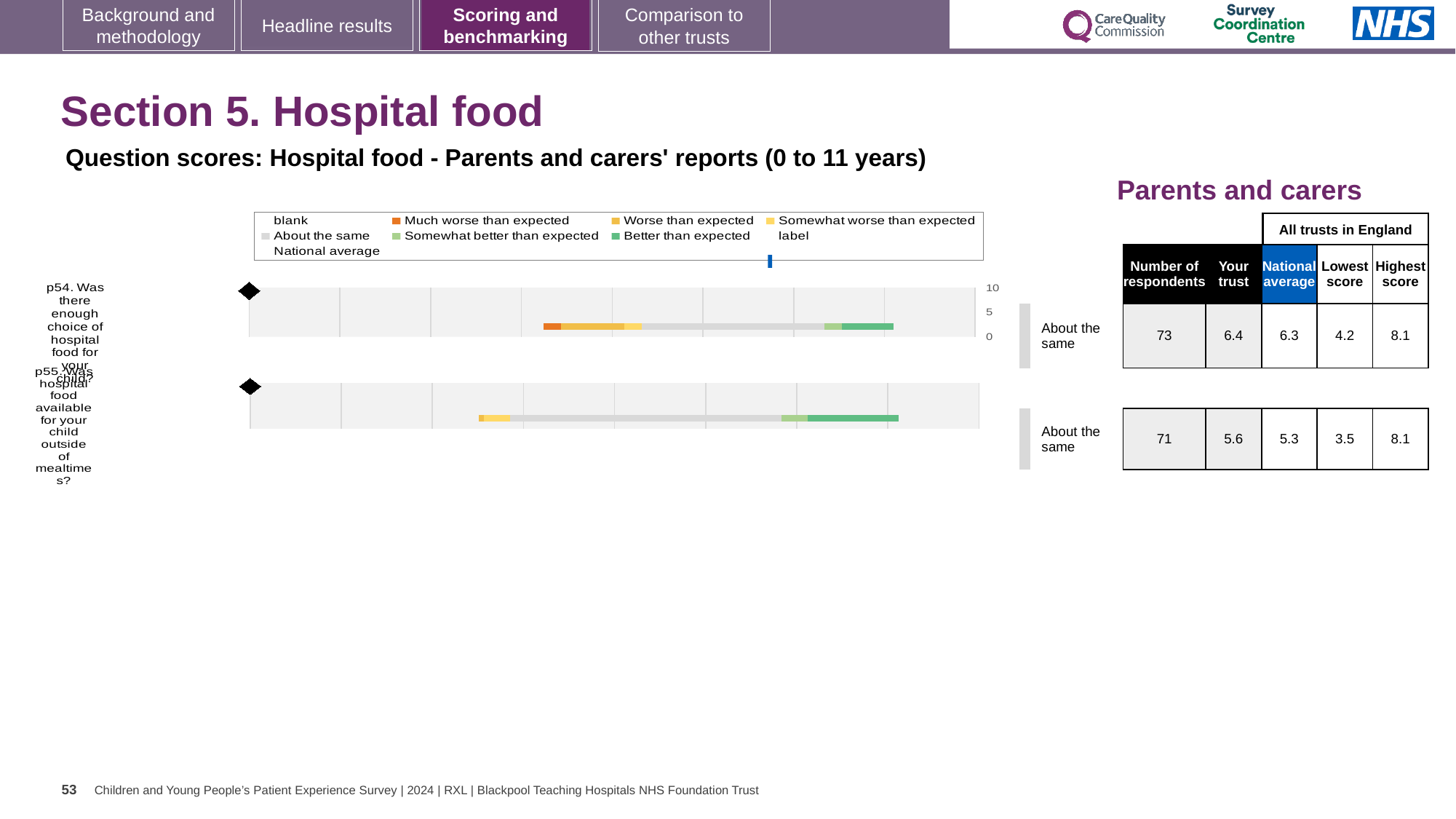
How many questions are plotted in the hospital food chart? 2 What is the difference between the highest and lowest scores for p55? 4.6 What kind of chart is used to show the question scores for p54 and p55? bar chart Which question has the higher 'Your trust' score, p54 or p55? p54 What is the national average score for p55 (hospital food available outside of mealtimes)? 5.3 What is the difference between the 'Your trust' score and the national average for p54? 0.1 What is the highest score across all trusts in England for p55? 8.1 How many respondents answered p54? 73 What colour represents 'Better than expected' in the legend? green What is the lowest score across all trusts in England for p54? 4.2 What benchmark category is shown for p55? About the same What is the 'Your trust' score for p54 (enough choice of hospital food)? 6.4